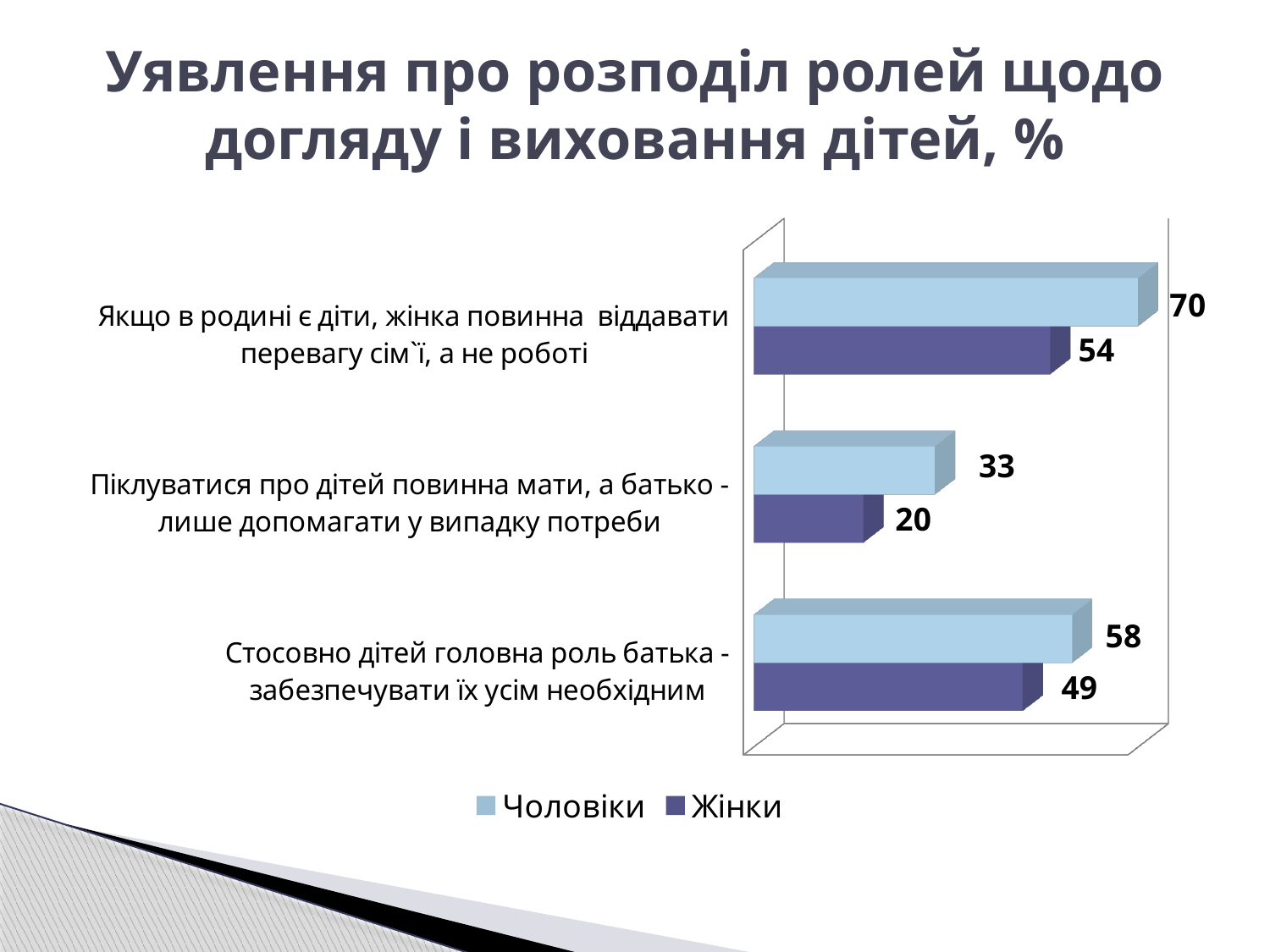
What is the difference between the Чоловіки and Жінки values for the statement "Піклуватися про дітей повинна мати, а батько - лише допомагати у випадку потреби"? 13 How many series does the legend list? 2 What is the value for Чоловіки for the statement "Якщо в родині є діти, жінка повинна віддавати перевагу сім`ї, а не роботі"? 70 Which statement has the highest value for Чоловіки? Якщо в родині є діти, жінка повинна віддавати перевагу сім`ї, а не роботі What is the value for Чоловіки for the statement "Стосовно дітей головна роль батька - забезпечувати їх усім необхідним"? 58 What type of chart is shown on the slide? bar chart How many statements (categories) are shown in the chart? 3 What is the difference between the Чоловіки and Жінки values for the statement "Якщо в родині є діти, жінка повинна віддавати перевагу сім`ї, а не роботі"? 16 What is the value for Жінки for the statement "Піклуватися про дітей повинна мати, а батько - лише допомагати у випадку потреби"? 20 Which statement has the lowest value for Жінки? Піклуватися про дітей повинна мати, а батько - лише допомагати у випадку потреби What is the value for Жінки for the statement "Стосовно дітей головна роль батька - забезпечувати їх усім необхідним"? 49 Which is larger: the Чоловіки value or the Жінки value for the statement "Стосовно дітей головна роль батька - забезпечувати їх усім необхідним"? Чоловіки